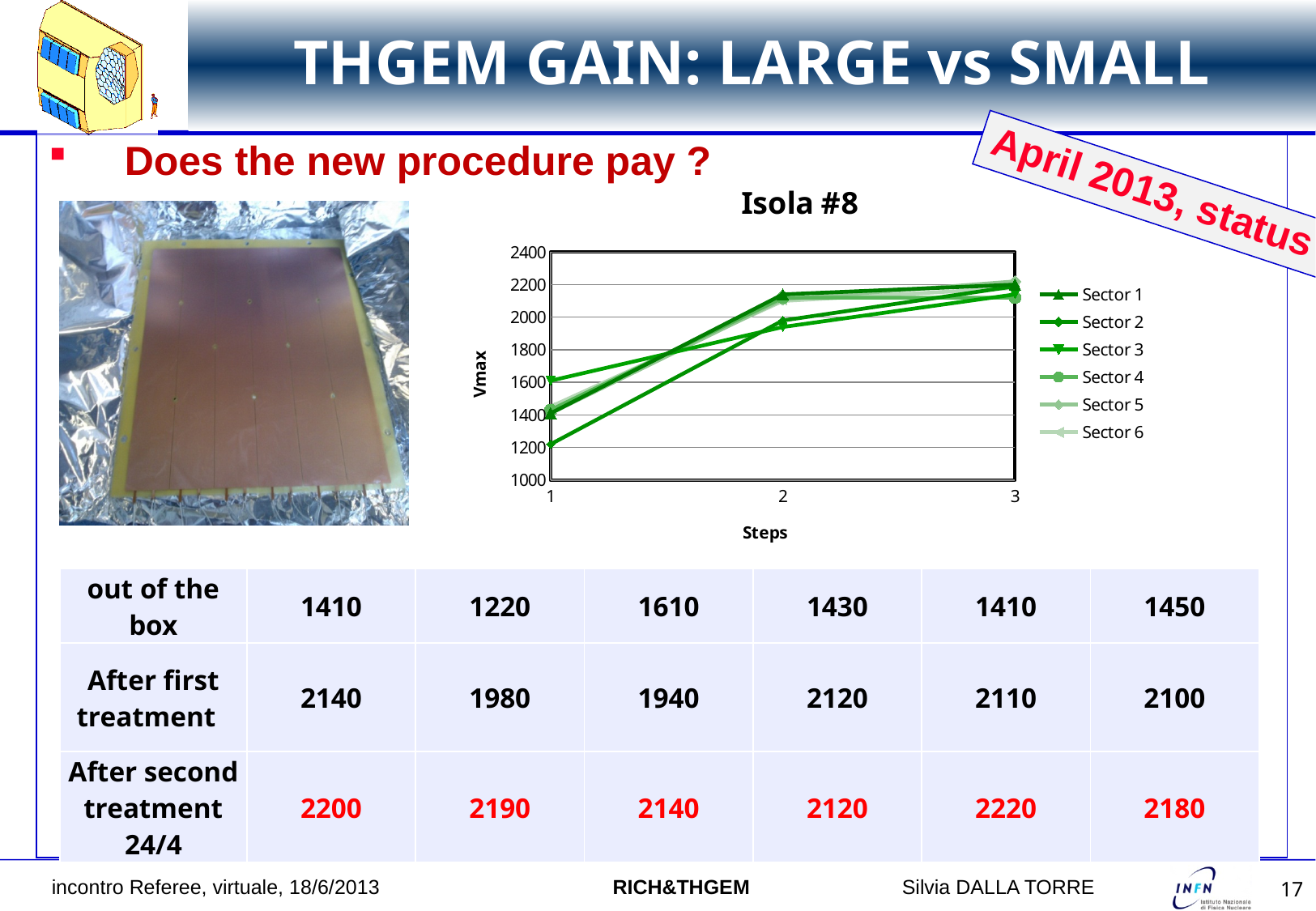
How many steps are plotted along the x axis of the chart? 3 At step 1, is the Vmax of Sector 3 larger or smaller than that of Sector 2? larger Is the Vmax of Sector 1 at step 3 greater or less than 2000? greater Do the Vmax values generally rise or fall from step 1 to step 3? rise What kind of chart is shown on the slide? line chart What is the label of the y axis of the chart? Vmax How many series does the chart legend list? 6 Is the Vmax of Sector 3 at step 1 greater or less than 1400? greater What is the title of the chart? Isola #8 Is the Vmax of Sector 2 at step 1 greater or less than 1400? less Which sector has the lowest Vmax at step 1? Sector 2 Which sector has the highest Vmax at step 1? Sector 3